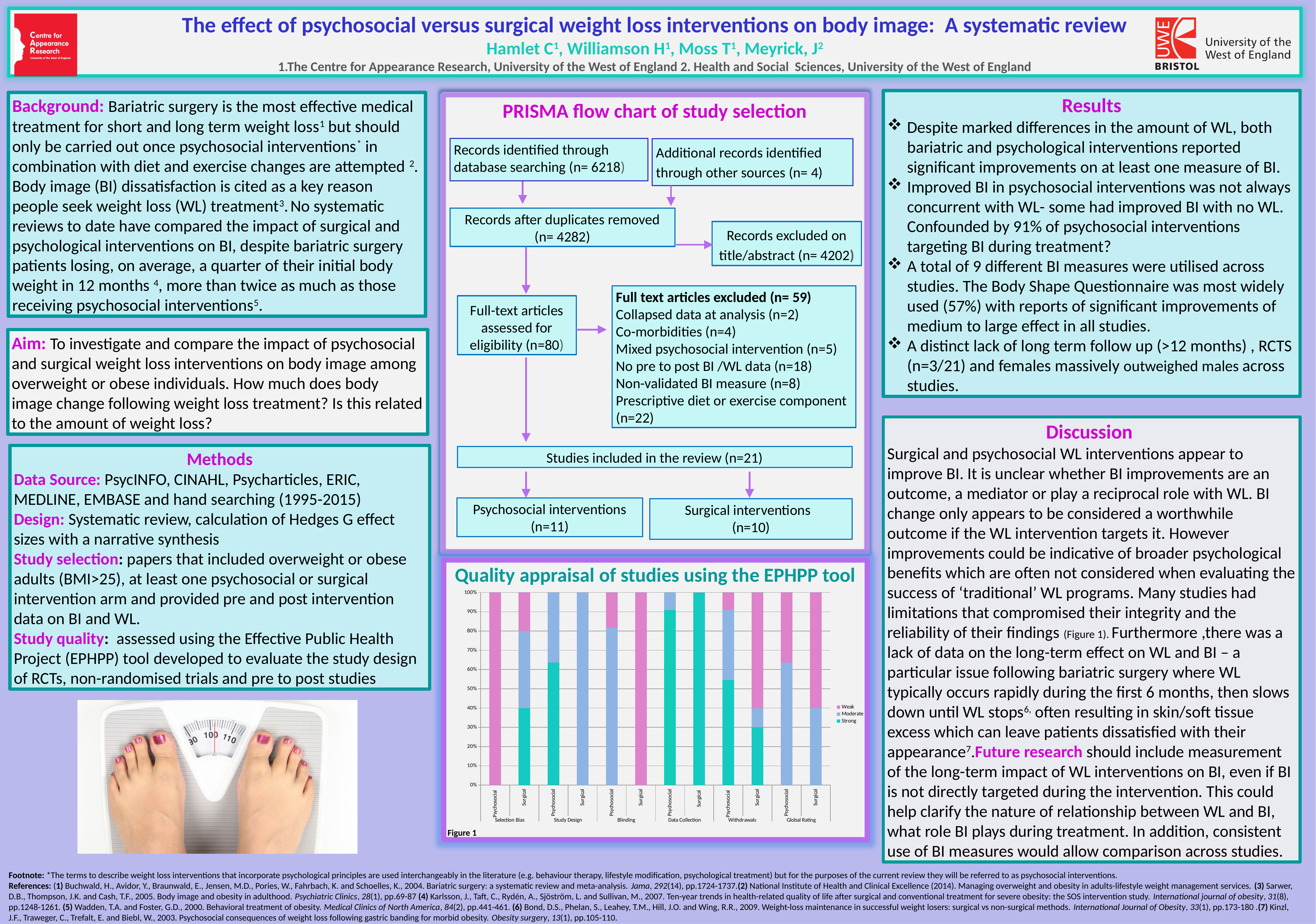
In the EPHPP quality appraisal chart, which category has the largest Weak share for Psychosocial studies? Selection Bias In the EPHPP quality appraisal chart, is the Weak share for Surgical studies under Withdrawals greater or less than 50%? greater How many series does the legend of the EPHPP quality appraisal chart list? 3 What kind of chart is 'Quality appraisal of studies using the EPHPP tool'? Stacked bar chart How many bars in total are plotted in the EPHPP quality appraisal chart? 12 In the EPHPP quality appraisal chart, is the Strong share for Surgical studies under Data Collection greater or less than 90%? greater How many appraisal categories (groups) are shown along the x axis of the EPHPP quality appraisal chart? 6 In the EPHPP quality appraisal chart, is the Weak share for Psychosocial studies under Blinding greater or less than 30%? less In the EPHPP quality appraisal chart, under Data Collection, which has the larger Strong share: Psychosocial or Surgical? Surgical What are the legend entries in the EPHPP quality appraisal chart? Weak, Moderate, Strong